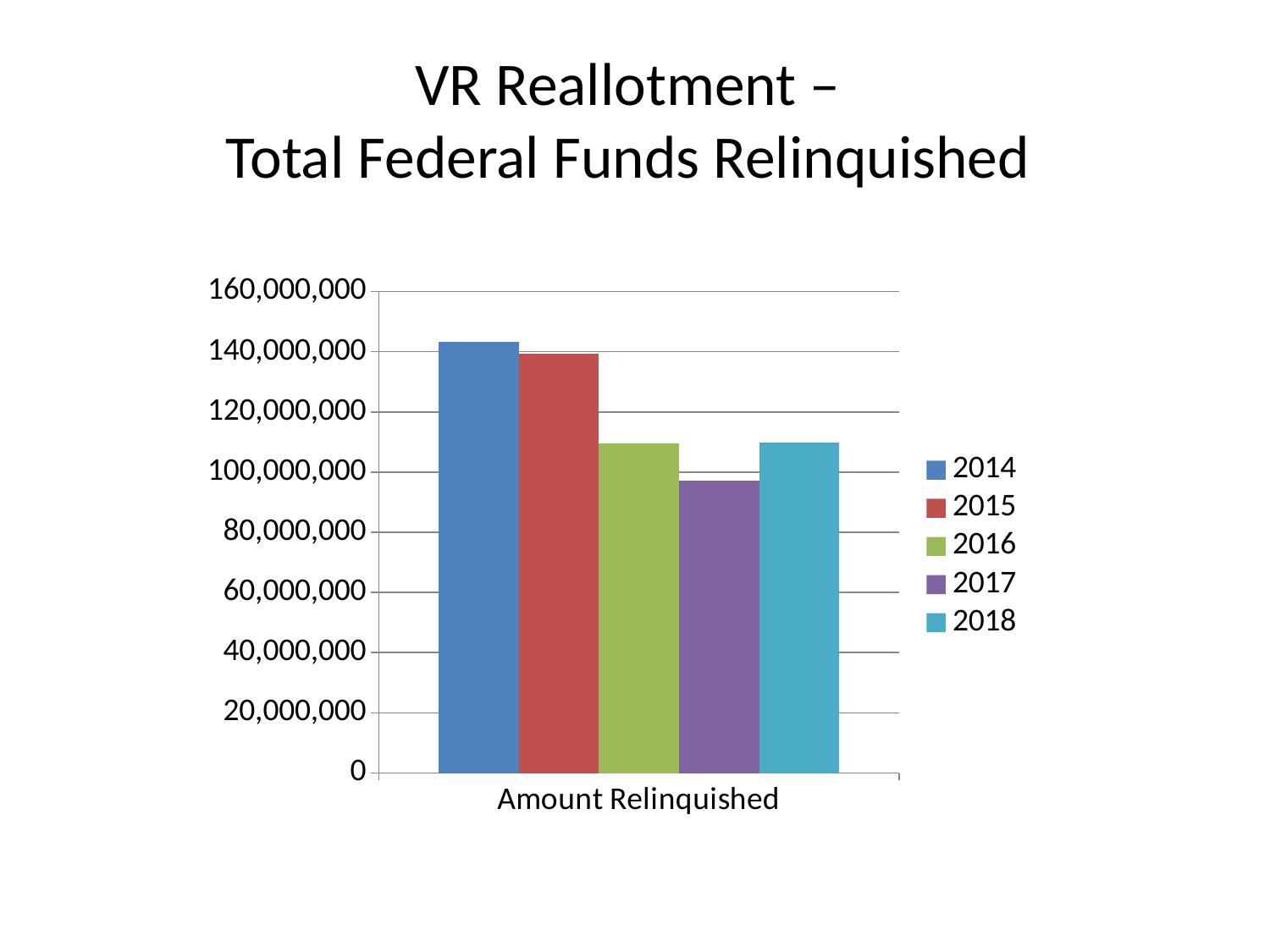
Is the value for 2017 greater or less than 100,000,000? less How many series does the legend list? 5 How many categories are shown on the x axis? 1 Which is larger, the amount relinquished in 2015 or in 2016? 2015 Which is larger, the amount relinquished in 2014 or in 2017? 2014 Is the value for 2018 greater or less than 100,000,000? greater Which year has the highest amount relinquished? 2014 What kind of chart is shown on the slide? bar chart Is the value for 2015 greater or less than 120,000,000? greater Which year has the lowest amount relinquished? 2017 What is the title of the slide's chart? VR Reallotment – Total Federal Funds Relinquished Do the values rise or fall from 2014 through 2017? fall